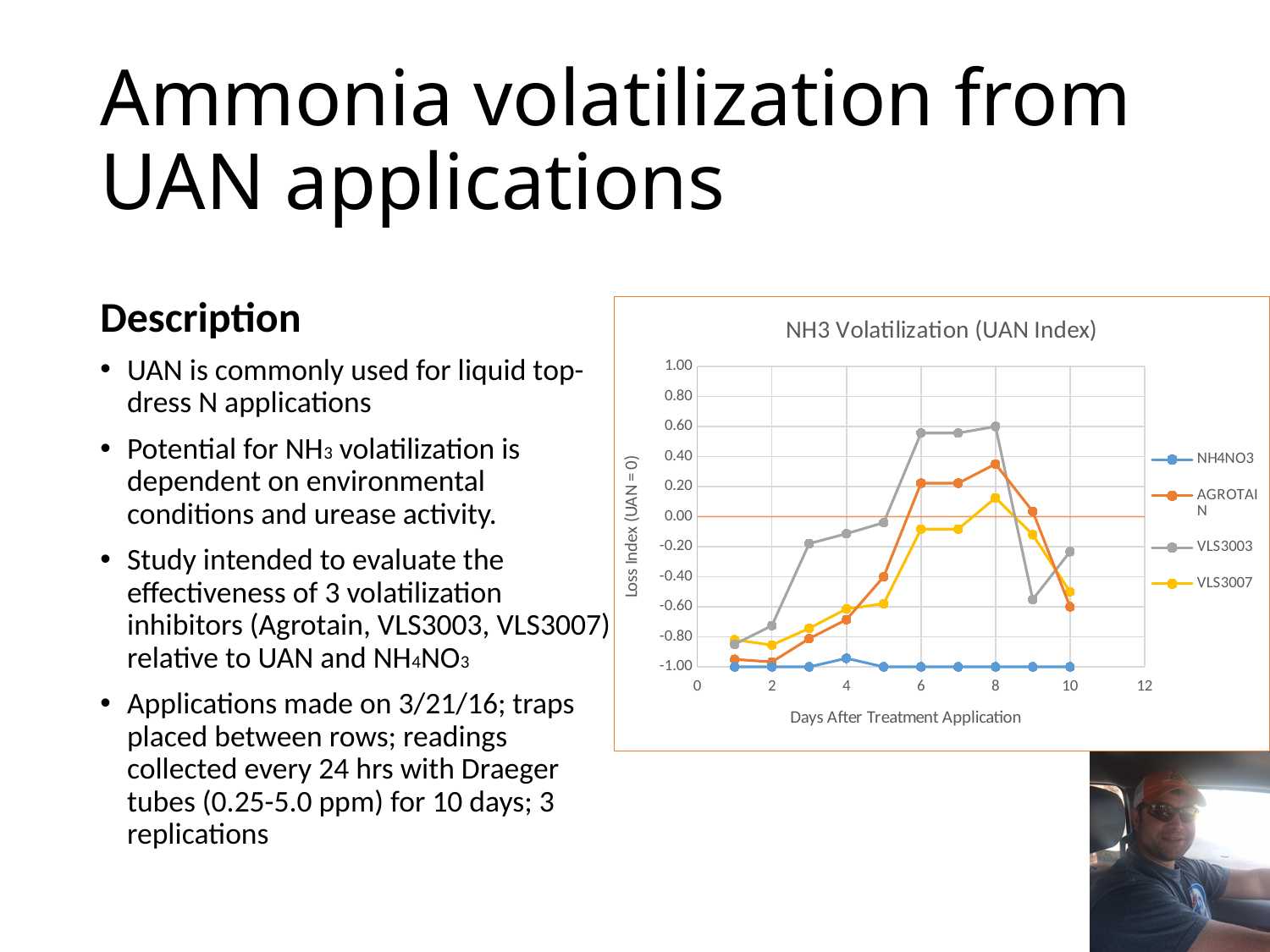
Which series has the lowest Loss Index values across the chart? NH4NO3 What kind of chart is shown on the slide? line chart What is the label of the x axis of the chart? Days After Treatment Application What is the title of the chart? NH3 Volatilization (UAN Index) At day 9, which series has the larger value, AGROTAIN or VLS3003? AGROTAIN Is the value for AGROTAIN at day 8 greater or less than 0.20? greater Is the value for VLS3003 at day 8 greater or less than 0.40? greater Does the VLS3003 series rise or fall from day 1 to day 8? rise At day 6, which series has the larger value, VLS3003 or AGROTAIN? VLS3003 Which series reaches the highest Loss Index value on the chart? VLS3003 Is the value for NH4NO3 at day 6 greater or less than -0.80? less How many series does the chart legend list? 4